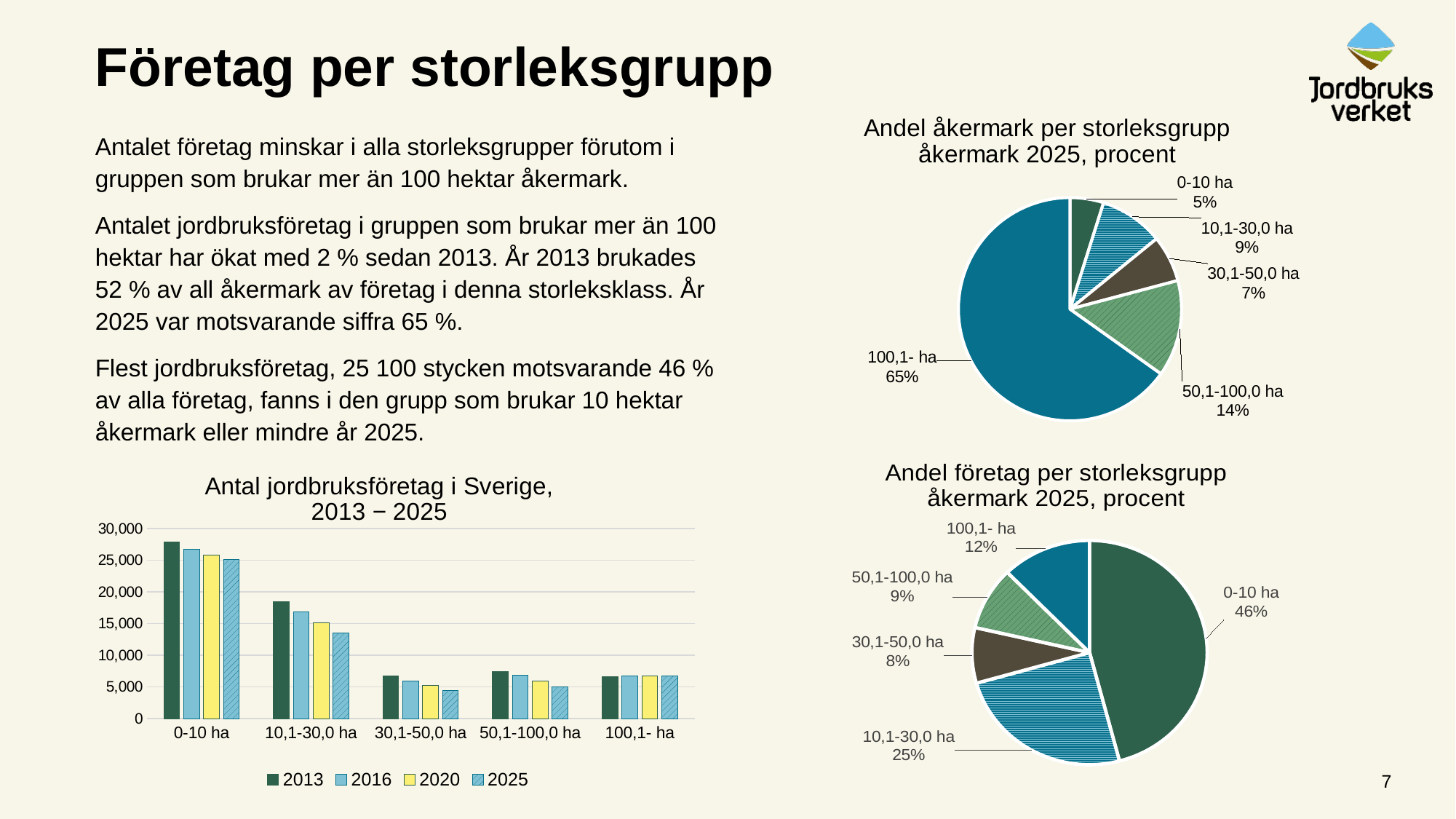
In the chart titled "Andel åkermark per storleksgrupp åkermark 2025, procent", which size group has the smallest share? 0-10 ha In the chart titled "Andel åkermark per storleksgrupp åkermark 2025, procent", what is the difference in percentage points between the 10,1-30,0 ha and 30,1-50,0 ha shares? 2 How many series does the legend of the chart "Antal jordbruksföretag i Sverige, 2013 − 2025" list? 4 In the chart titled "Andel företag per storleksgrupp åkermark 2025, procent", which is larger: the share for 50,1-100,0 ha or for 30,1-50,0 ha? 50,1-100,0 ha In the chart "Antal jordbruksföretag i Sverige, 2013 − 2025", how many size-group categories are shown on the x axis? 5 In the chart titled "Andel åkermark per storleksgrupp åkermark 2025, procent", what share does the 100,1- ha group have? 65% In the chart titled "Andel företag per storleksgrupp åkermark 2025, procent", what share does the 100,1- ha group have? 12% In the chart "Antal jordbruksföretag i Sverige, 2013 − 2025", is the 2013 value for 0-10 ha greater or less than 25,000? greater In the chart titled "Andel åkermark per storleksgrupp åkermark 2025, procent", what share does the 50,1-100,0 ha group have? 14% In the chart titled "Andel företag per storleksgrupp åkermark 2025, procent", which size group has the largest share? 0-10 ha What kind of chart is "Antal jordbruksföretag i Sverige, 2013 − 2025"? bar chart In the chart titled "Andel företag per storleksgrupp åkermark 2025, procent", what share does the 0-10 ha group have? 46%